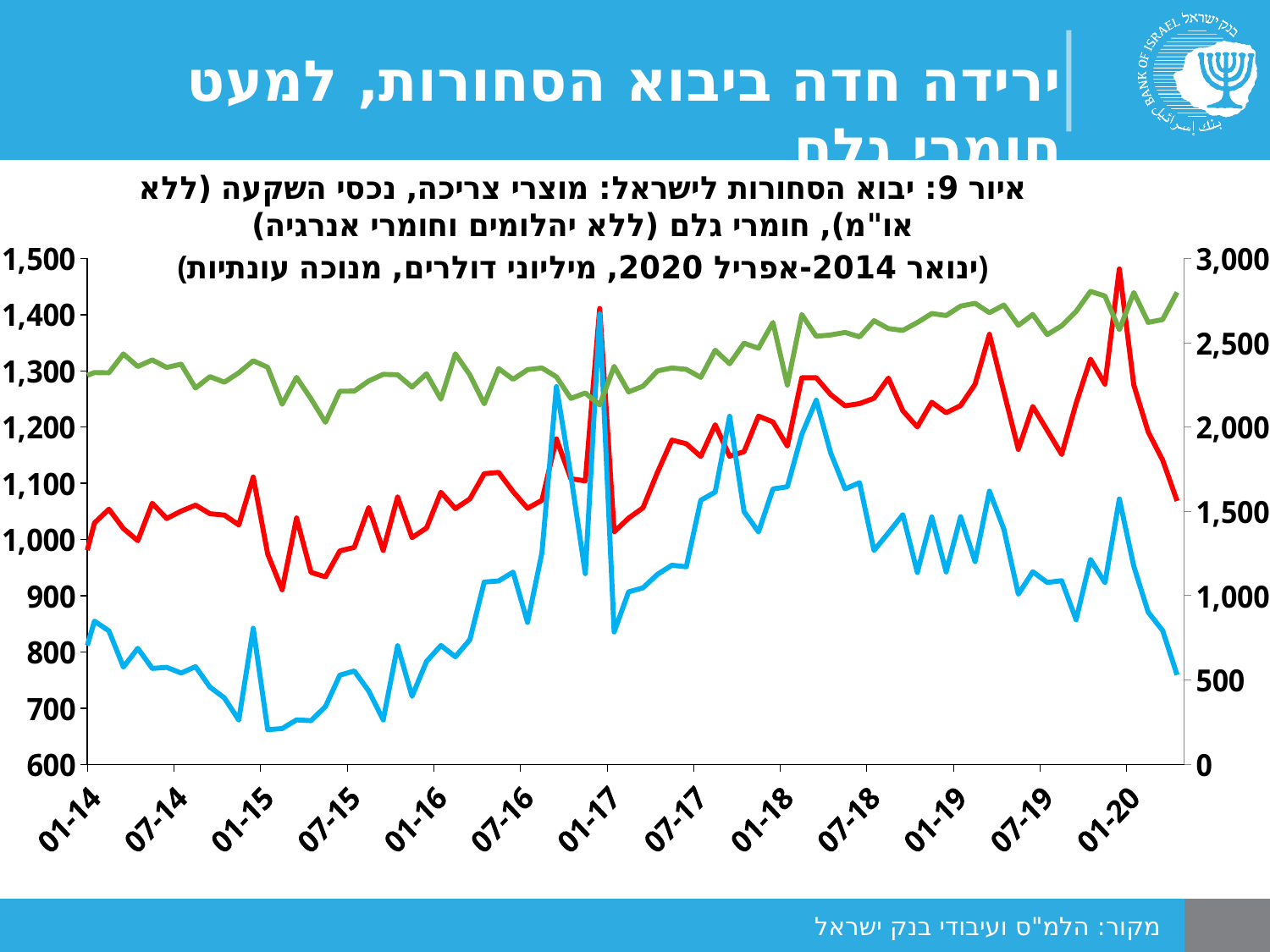
Which coloured line is plotted highest on the chart across the whole period? green What is the highest value shown on the left vertical axis? 1,500 What is the highest value shown on the right vertical axis? 3,000 What is the last date label on the horizontal axis? 01-20 How many lines are plotted on the chart? 3 Which line is higher at 01-14, the green line or the blue line? green What is the lowest value shown on the left vertical axis? 600 Over the whole period from 01-14 to 01-20, does the green line generally rise or fall? rise Which coloured line is plotted lowest on the chart for most of the period? blue What kind of chart is shown on the slide? line chart What is the first date label on the horizontal axis? 01-14 At the right end of the chart (after 01-20), do the red and blue lines rise or fall? fall